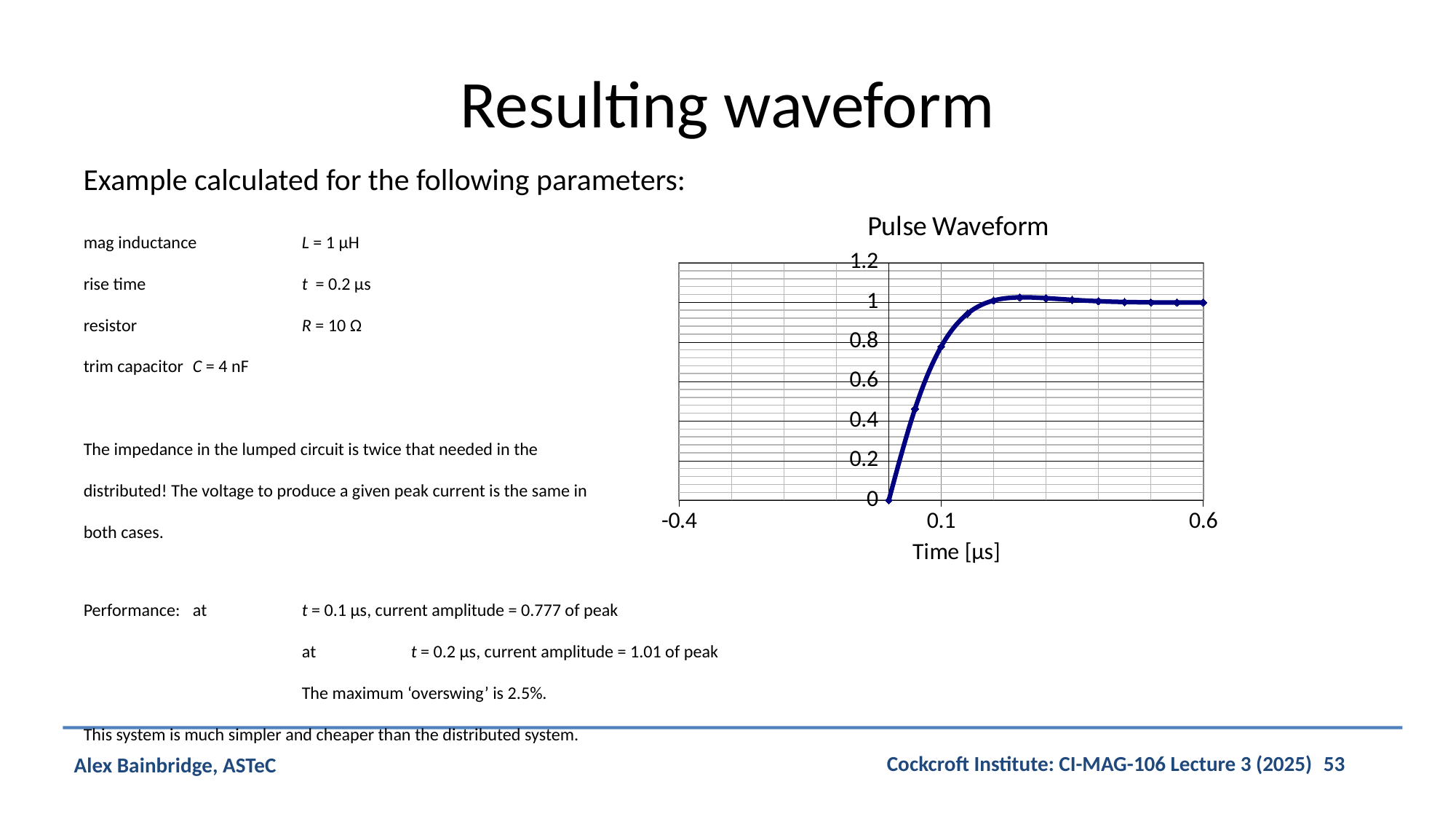
What is the label of the x axis on the Pulse Waveform chart? Time [μs] On the Pulse Waveform chart, is the value at time 0.6 larger or smaller than the value at time 0.1? larger What is the highest tick value shown on the y axis of the Pulse Waveform chart? 1.2 What is the title of the chart on the slide? Pulse Waveform On the Pulse Waveform chart, does the plotted value rise or fall between time 0 and time 0.1? rise What kind of chart is the Pulse Waveform chart? line chart On the Pulse Waveform chart, is the value at time 0.1 greater or less than 0.6? greater On the Pulse Waveform chart, is the value at time 0.1 greater or less than 1? less On the Pulse Waveform chart, is the value at time 0.6 greater or less than 1.2? less